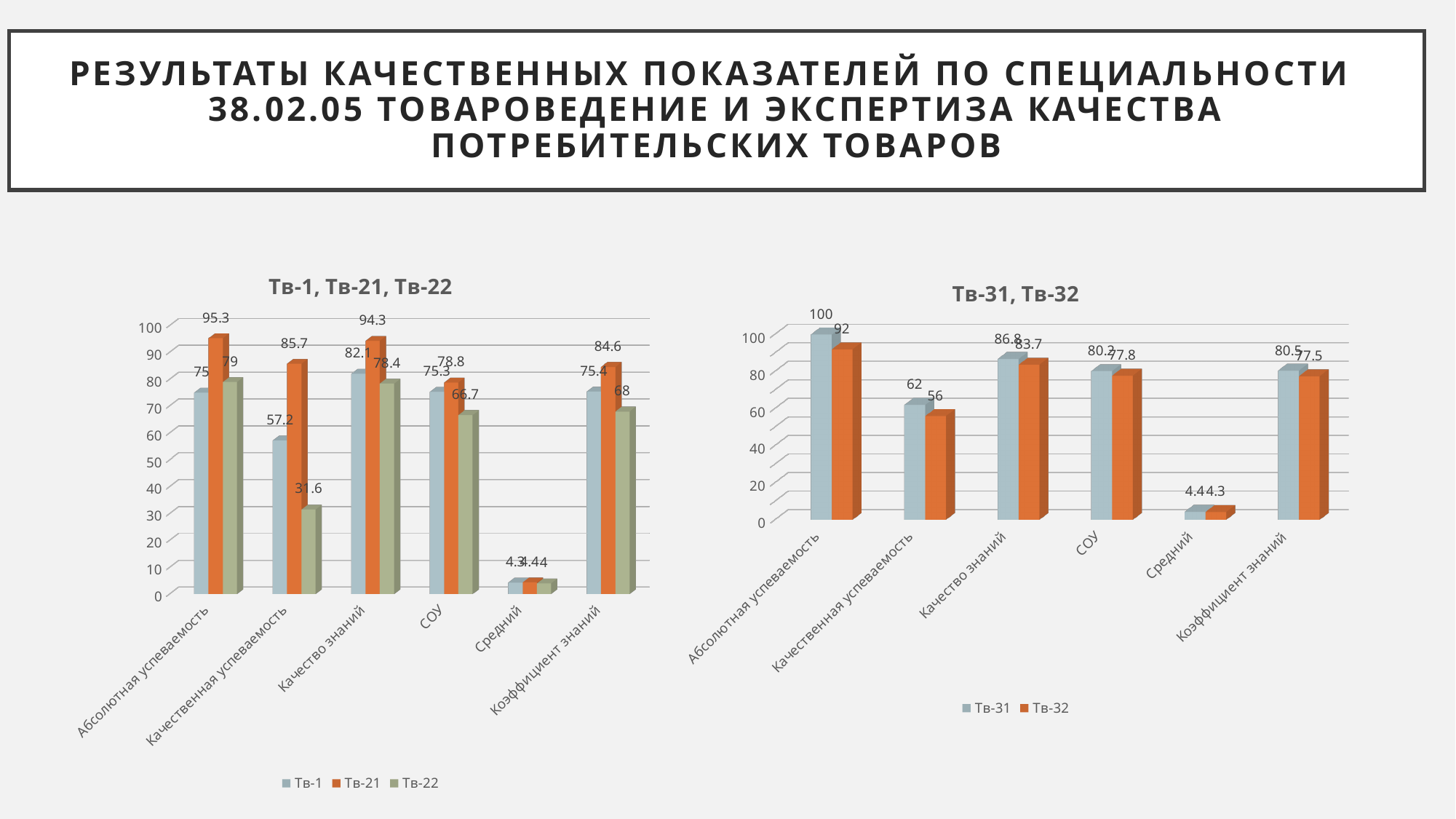
In the chart titled 'Тв-1, Тв-21, Тв-22', is the Тв-1 value for 'Качественная успеваемость' greater or less than 60? less What type of chart is the chart titled 'Тв-31, Тв-32'? Bar chart In the chart titled 'Тв-1, Тв-21, Тв-22', which series has the highest value in the category 'Качество знаний'? Тв-21 In the chart titled 'Тв-31, Тв-32', what is the difference between the Тв-31 and Тв-32 values for 'Качественная успеваемость'? 6 In the chart titled 'Тв-1, Тв-21, Тв-22', what is the value for Тв-21 in the category 'Абсолютная успеваемость'? 95.3 In the chart titled 'Тв-31, Тв-32', what is the value for Тв-32 in the category 'СОУ'? 77.8 In the chart titled 'Тв-31, Тв-32', how many categories are shown on the x axis? 6 In the chart titled 'Тв-1, Тв-21, Тв-22', what is the value for Тв-22 in the category 'Качественная успеваемость'? 31.6 In the chart titled 'Тв-1, Тв-21, Тв-22', what is the difference between the Тв-21 and Тв-1 values for 'Коэффициент знаний'? 9.2 In the chart titled 'Тв-31, Тв-32', what is the value for Тв-31 in the category 'Абсолютная успеваемость'? 100 In the chart titled 'Тв-31, Тв-32', which category has the lowest values for both series? Средний In the chart titled 'Тв-1, Тв-21, Тв-22', how many series does the legend list? 3